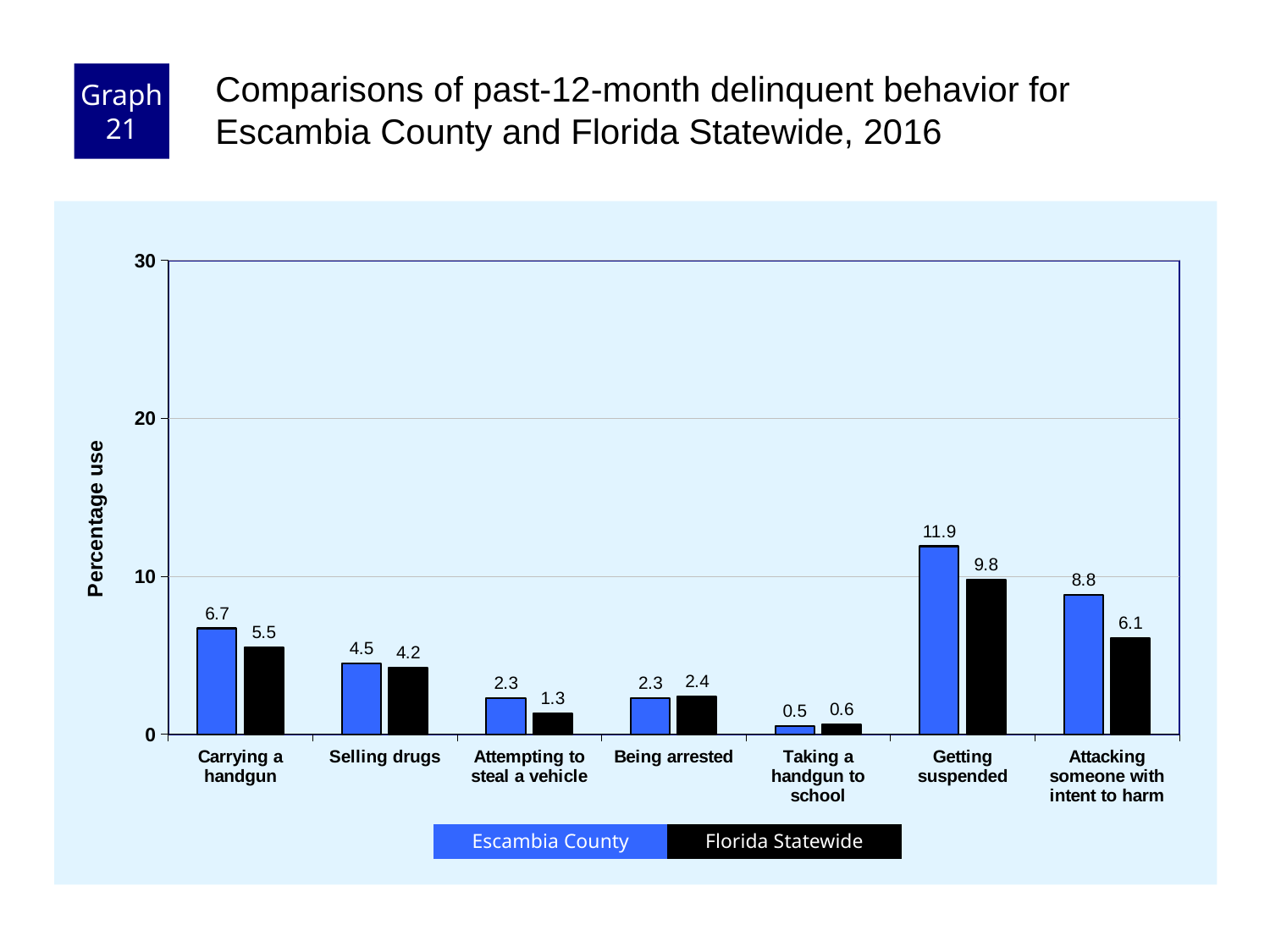
What is the Escambia County value for Getting suspended? 11.9 Is the Escambia County value for Getting suspended greater or less than 10? greater Which category has the lowest Florida Statewide value? Taking a handgun to school Which category has the highest Escambia County value? Getting suspended What is the difference between the Escambia County and Florida Statewide values for Attacking someone with intent to harm? 2.7 What is the Escambia County value for Taking a handgun to school? 0.5 How many categories are shown on the x axis? 7 What is the label of the y axis? Percentage use What is the Florida Statewide value for Attacking someone with intent to harm? 6.1 What kind of chart is shown on the slide? Bar chart How many series does the legend list? 2 Which is larger for Attempting to steal a vehicle: Escambia County or Florida Statewide? Escambia County